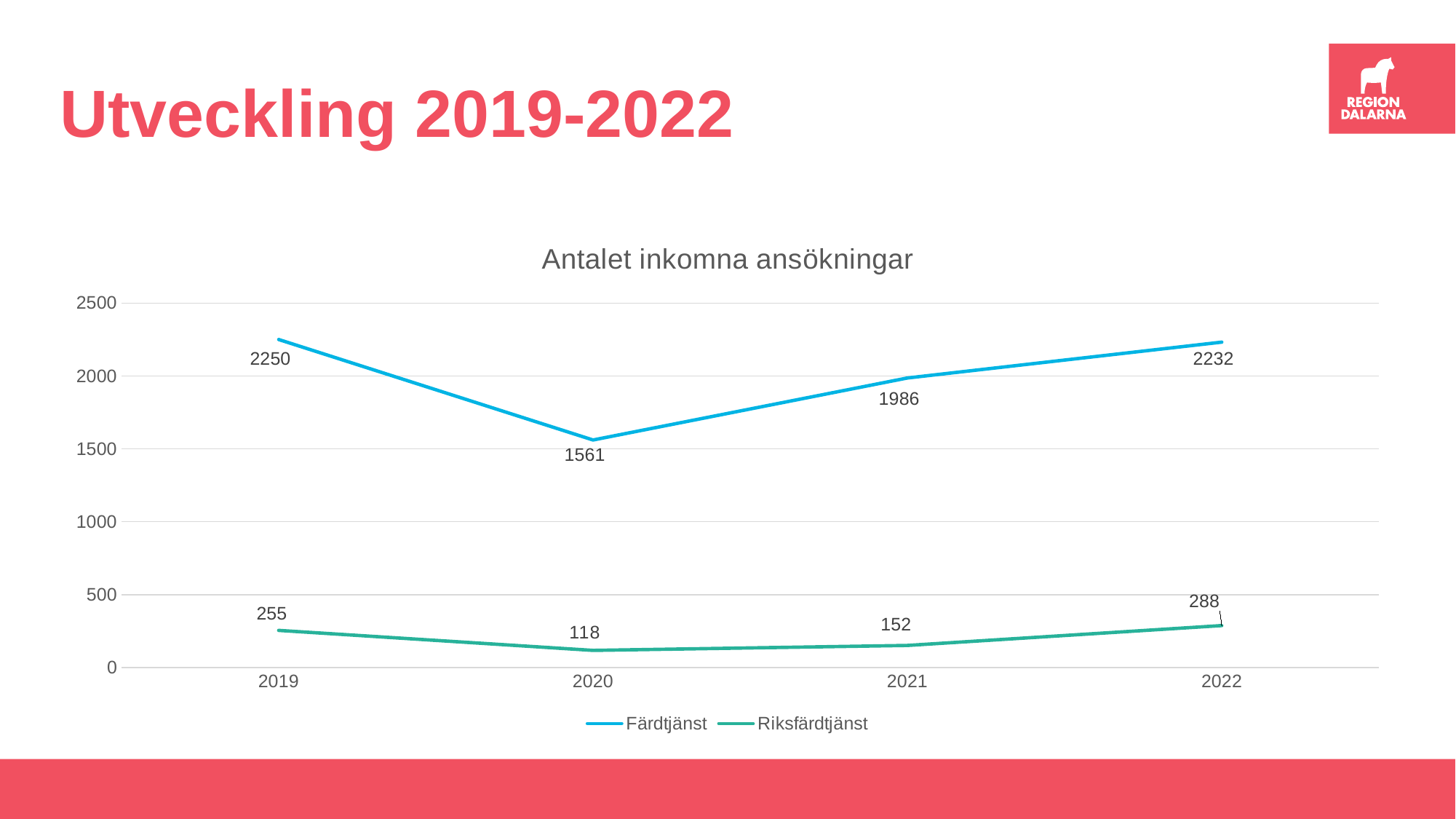
In which year is the Riksfärdtjänst value lowest? 2020 What is the title of the chart? Antalet inkomna ansökningar What kind of chart is shown on the slide? Line chart What is the difference between the Riksfärdtjänst values for 2022 and 2021? 136 What is the difference between the Färdtjänst values for 2019 and 2020? 689 How many years are shown on the x axis? 4 What is the value for Färdtjänst in 2020? 1561 What is the value for Riksfärdtjänst in 2022? 288 How many series does the legend list? 2 Which is larger, the Färdtjänst value for 2019 or for 2022? 2019 What is the value for Färdtjänst in 2021? 1986 In which year is the Färdtjänst value highest? 2019